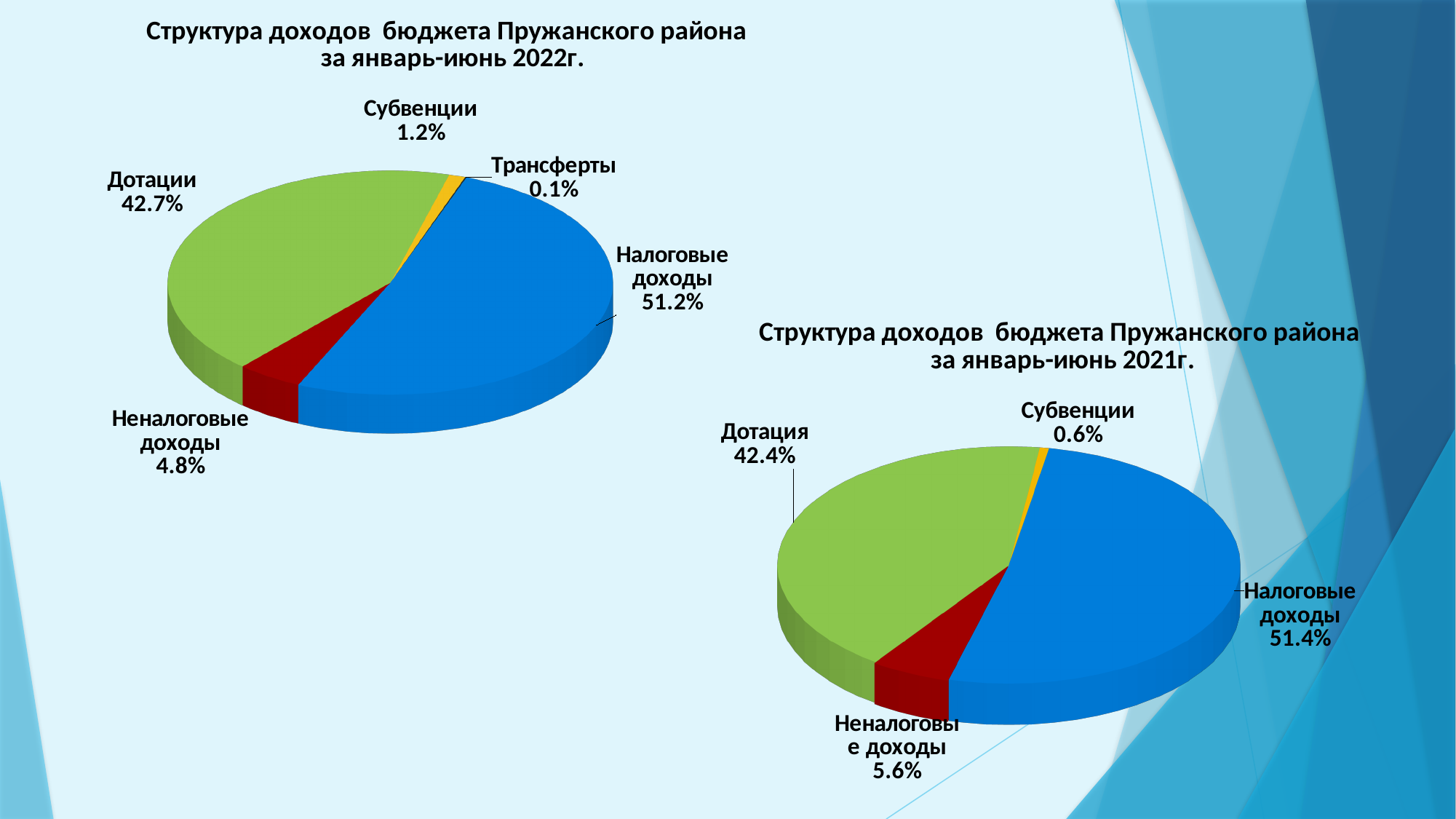
In the chart for January-June 2022, which category has the smallest share? Трансферты In the chart for January-June 2022, what is the difference between Дотации and Неналоговые доходы? 37.9% In the chart for January-June 2021, which category has the smallest share? Субвенции In the chart for January-June 2021, what is the difference between Налоговые доходы and Дотация? 9.0% In the chart for January-June 2022, what is the value for Трансферты? 0.1% In the chart for January-June 2021, what is the value for Субвенции? 0.6% Which is larger: Неналоговые доходы in the 2022 chart or Неналоговые доходы in the 2021 chart? 2021 chart In the chart for January-June 2022, which category has the largest share? Налоговые доходы In the chart for January-June 2022, what share do Налоговые доходы have? 51.2% How many categories are shown in the chart for January-June 2022? 5 In the chart for January-June 2021, what share do Дотация have? 42.4% What type of chart is used for the January-June 2021 data? Pie chart